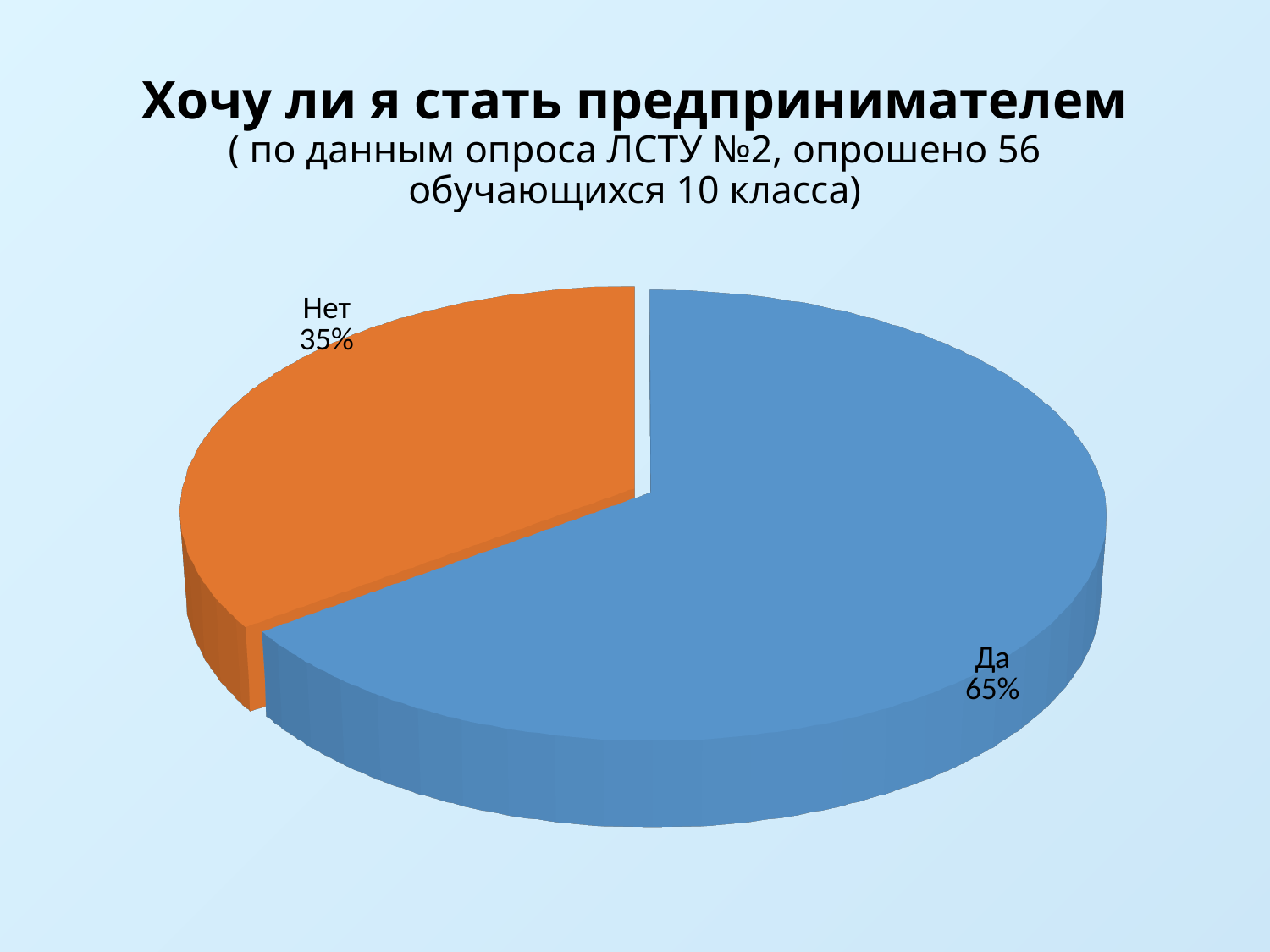
What is the difference in percentage points between the "Да" and "Нет" slices? 30 What colour is the "Да" slice? Blue Which answer has the largest share of the pie? Да What percentage of respondents answered "Да"? 65% Which slice is larger, "Да" or "Нет"? Да What share of the pie does the "Нет" slice represent? 35% How many slices does the pie chart have? 2 How many students were surveyed according to the chart subtitle? 56 Which answer has the smallest share of the pie? Нет What kind of chart is shown on the slide? Pie chart What percentage of respondents answered "Нет"? 35%